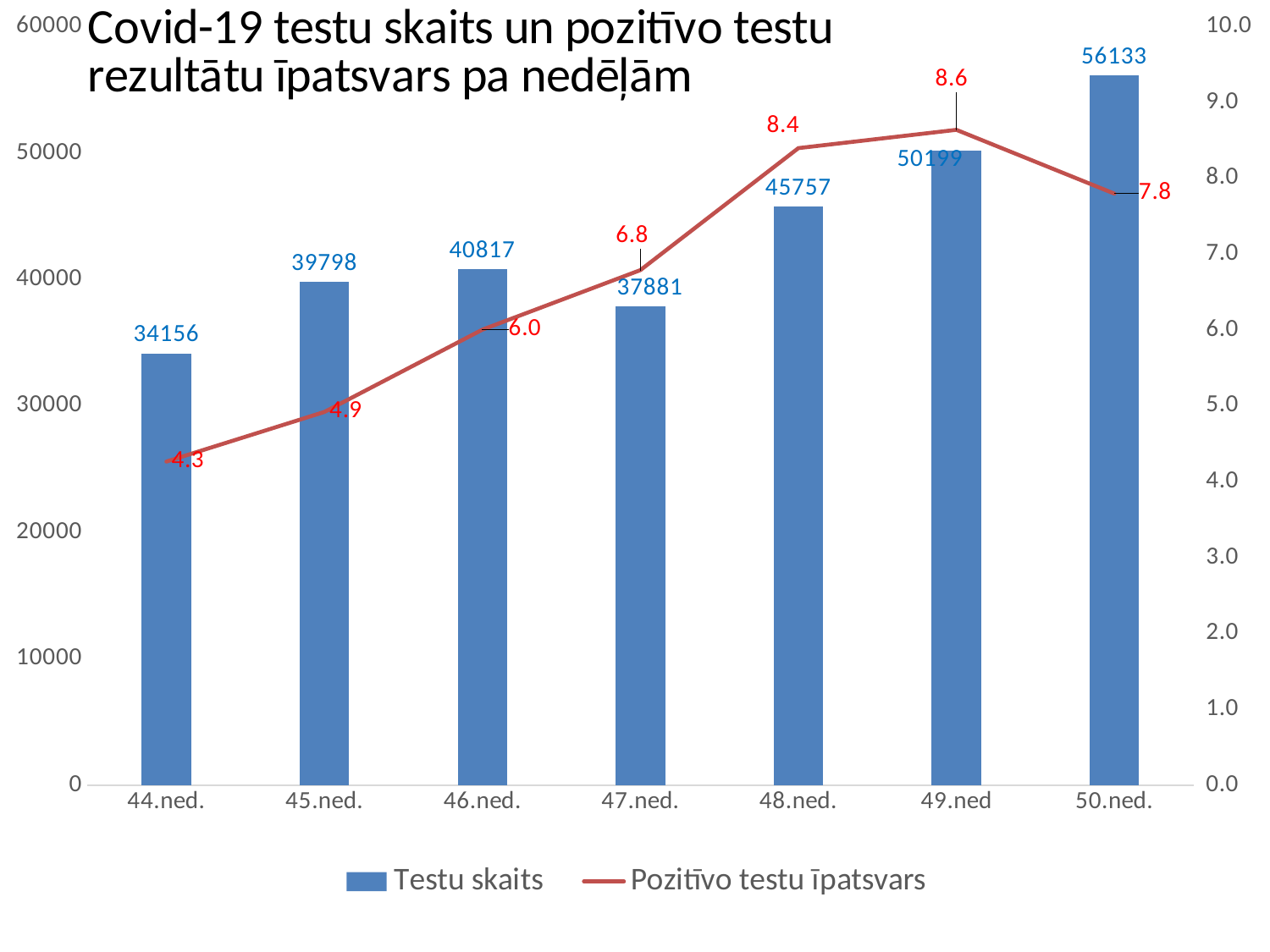
How many weeks are shown on the x axis? 7 What kind of chart is used for the Testu skaits series? bar chart What is the title of the chart? Covid-19 testu skaits un pozitīvo testu rezultātu īpatsvars pa nedēļām Which week has the highest Testu skaits? 50.ned. Is the Testu skaits value for 48.ned. greater or less than 40000? greater Does the Pozitīvo testu īpatsvars line rise or fall from 44.ned. to 49.ned? rise What is the difference in Testu skaits between 50.ned. and 49.ned? 5934 Which week has the higher Testu skaits, 46.ned. or 47.ned.? 46.ned. What is the Pozitīvo testu īpatsvars value for 48.ned.? 8.4 What is the value of Testu skaits for 44.ned.? 34156 Which week has the lowest Pozitīvo testu īpatsvars? 44.ned. How many series does the legend list? 2